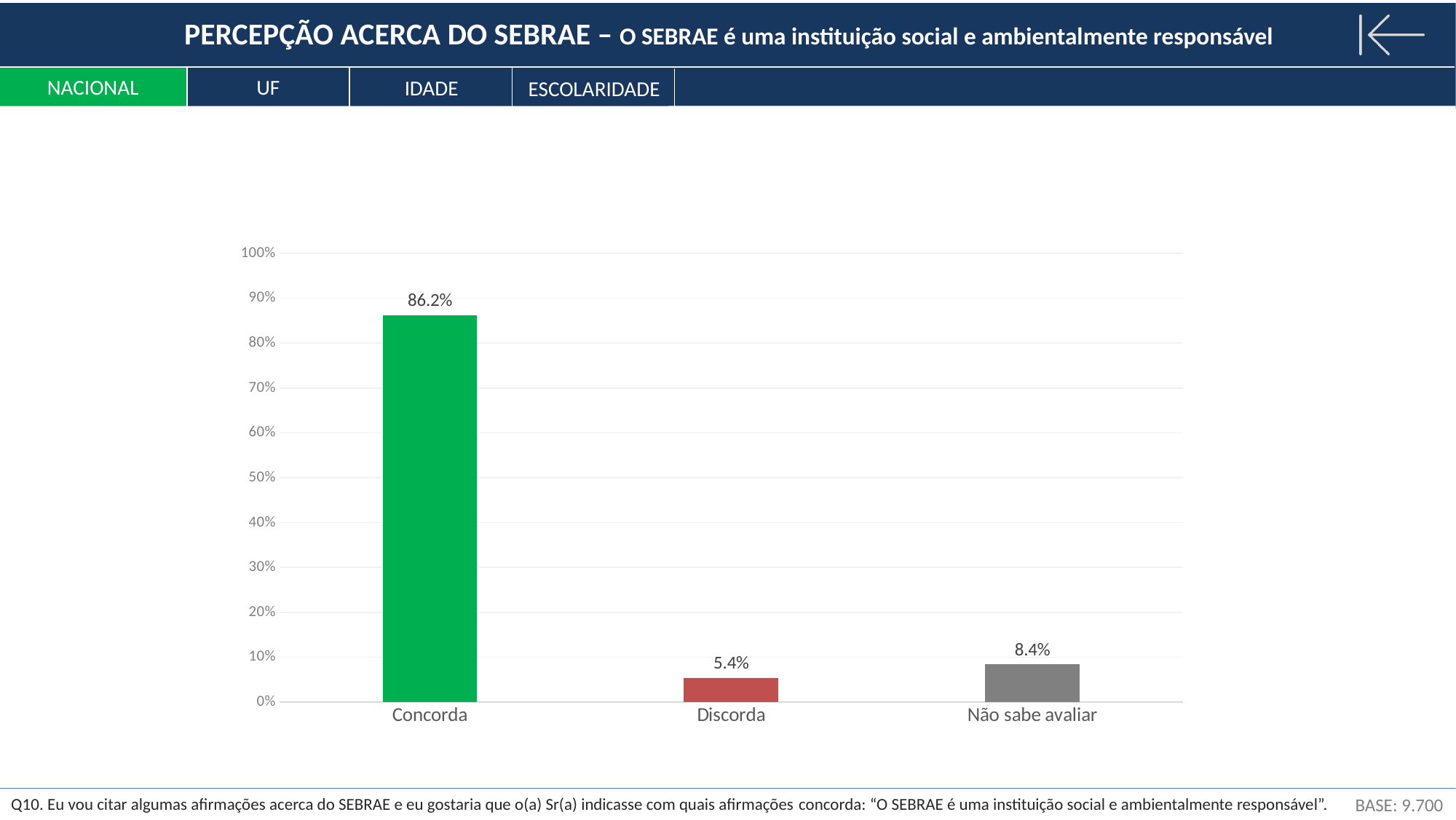
Which category has the highest value? Concorda What is the difference between the values for Não sabe avaliar and Discorda? 3.0% Is the value for Concorda greater or less than 80%? greater What is the value for Concorda? 86.2% What is the value for Não sabe avaliar? 8.4% What is the value for Discorda? 5.4% How many categories are shown on the x axis? 3 Which is larger, the value for Discorda or the value for Não sabe avaliar? Não sabe avaliar What colour is the bar for Concorda? green What kind of chart is shown on the slide? bar chart Which category has the lowest value? Discorda What is the difference between the values for Concorda and Discorda? 80.8%